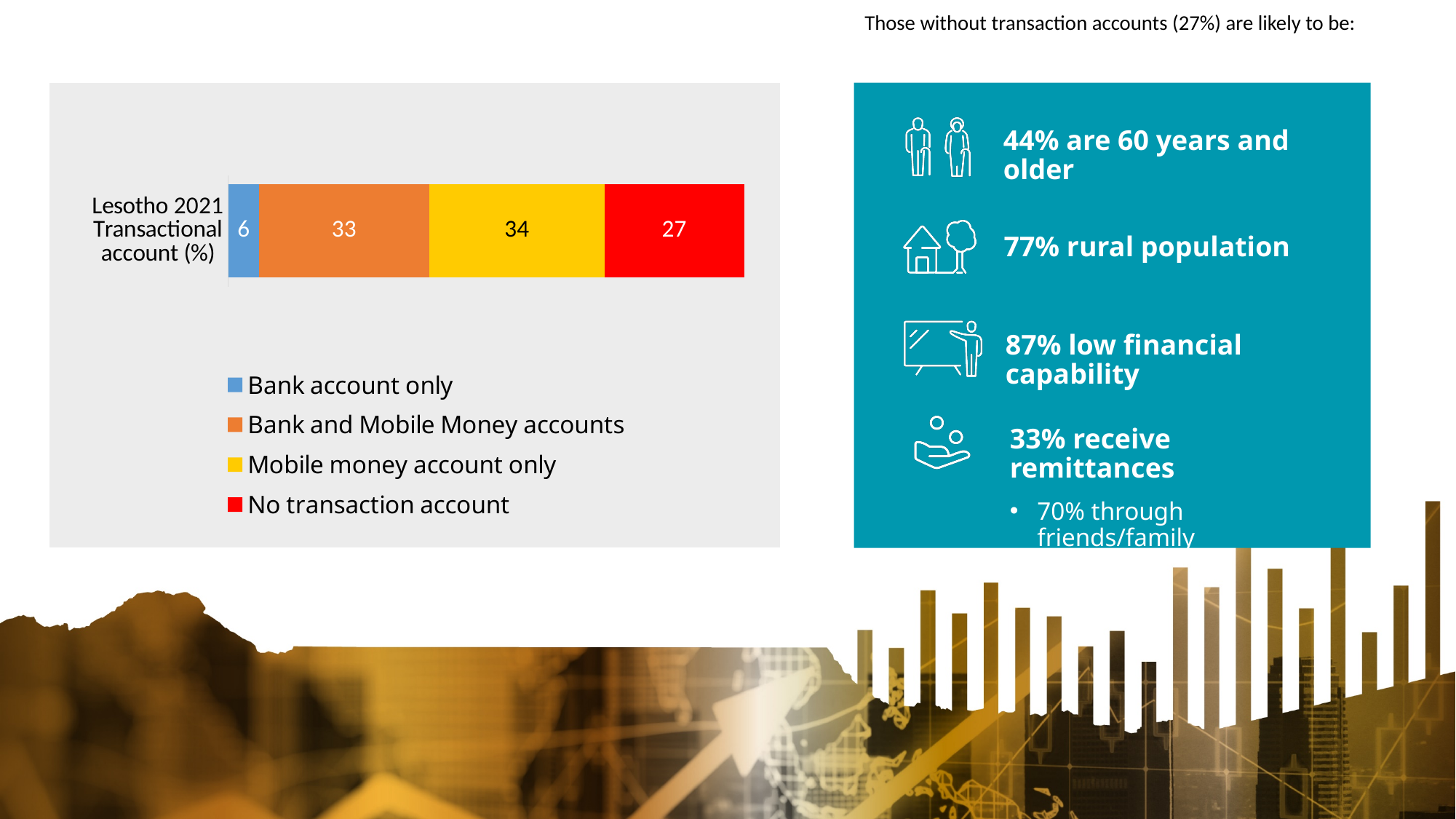
What is the value for No transaction account in the chart? 27 What is the total of the stacked bar for Lesotho 2021 Transactional account (%)? 100 What is the value for Bank account only in the Lesotho 2021 Transactional account (%) chart? 6 What is the value for Bank and Mobile Money accounts in the chart? 33 What kind of chart is shown on the slide? Stacked bar chart What colour represents No transaction account in the chart? Red Which series has the highest value in the chart? Mobile money account only How many series does the legend list? 4 Which is larger: the value for Bank and Mobile Money accounts or the value for No transaction account? Bank and Mobile Money accounts What is the difference between the values for Mobile money account only and No transaction account? 7 What is the value for Mobile money account only in the chart? 34 Which series has the lowest value in the chart? Bank account only